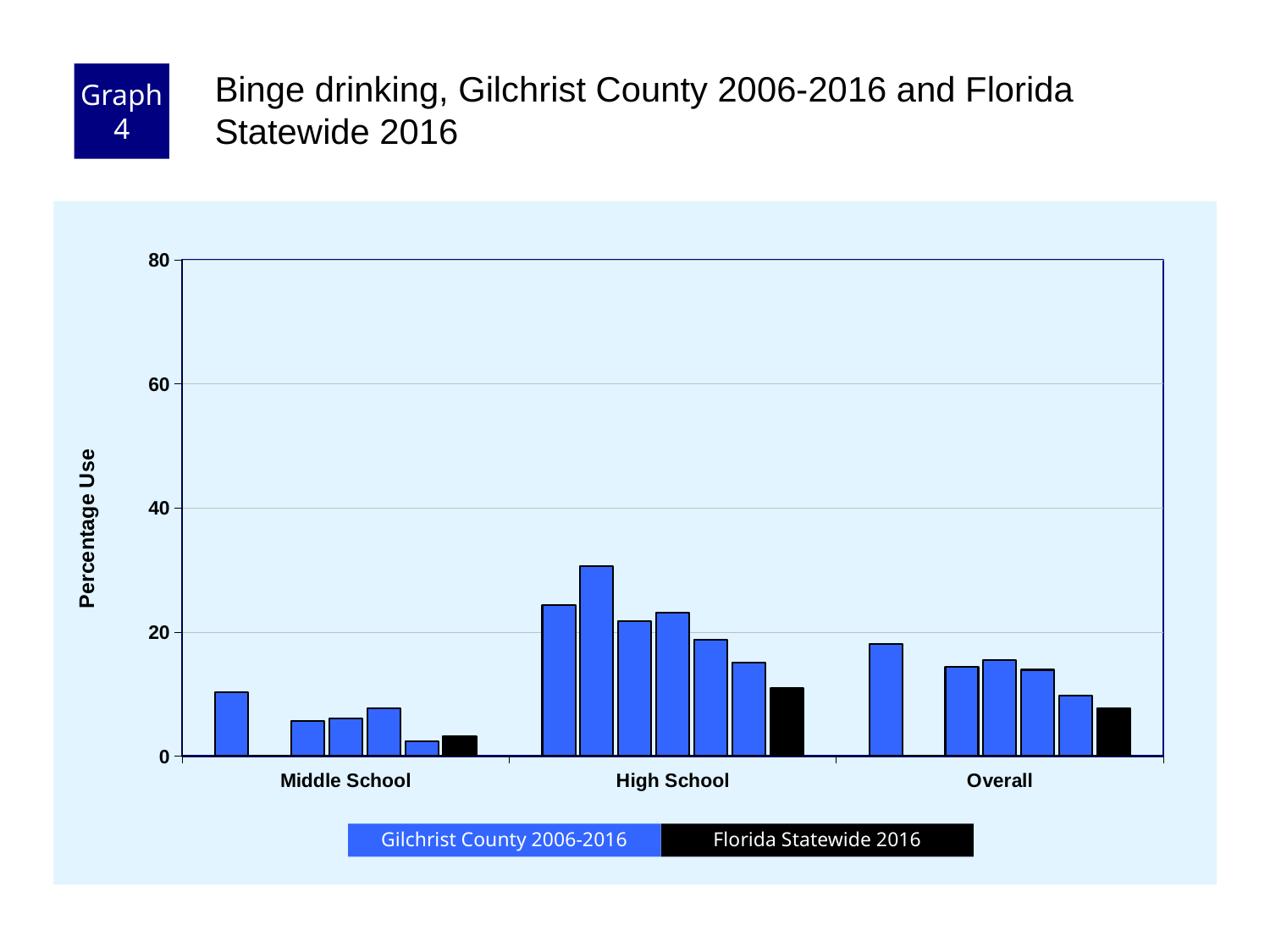
Which category contains the tallest bar in the chart? High School What kind of chart is shown on the slide? Bar chart How many series does the chart legend list? 2 Is the Florida Statewide 2016 value for High School greater or less than 20? less Is the tallest Gilchrist County 2006-2016 bar for High School greater or less than 20? greater What is the label on the y axis of the chart? Percentage Use How many categories are shown along the x axis of the chart? 3 Which category has the lowest Florida Statewide 2016 bar? Middle School What is the title of the chart on the slide? Binge drinking, Gilchrist County 2006-2016 and Florida Statewide 2016 Are all the bars in the chart below 40? Yes Which is larger, the Florida Statewide 2016 value for High School or for Overall? High School